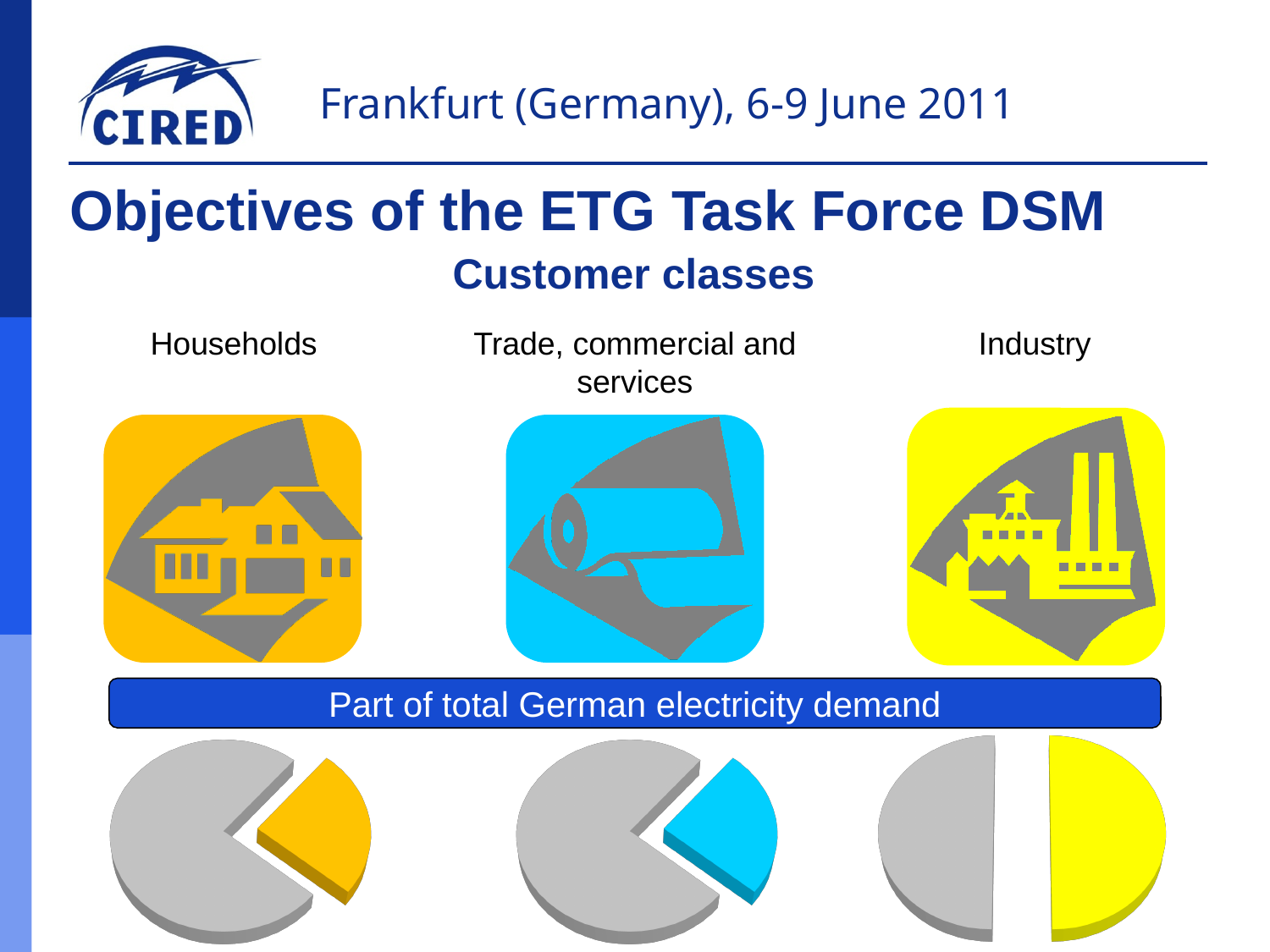
How many pie charts are shown on the slide? 3 Is the highlighted share of total German electricity demand larger for Industry or for Trade, commercial and services? Industry What colour is the highlighted slice in the Trade, commercial and services pie chart? light blue What colour is the highlighted slice in the Households pie chart? orange How many slices does the Households pie chart have? 2 Is the highlighted share of total German electricity demand larger for Industry or for Households? Industry Which customer class has the largest highlighted share of total German electricity demand? Industry How many slices does the Industry pie chart have? 2 What kind of chart is used to show the part of total German electricity demand for each customer class? pie chart